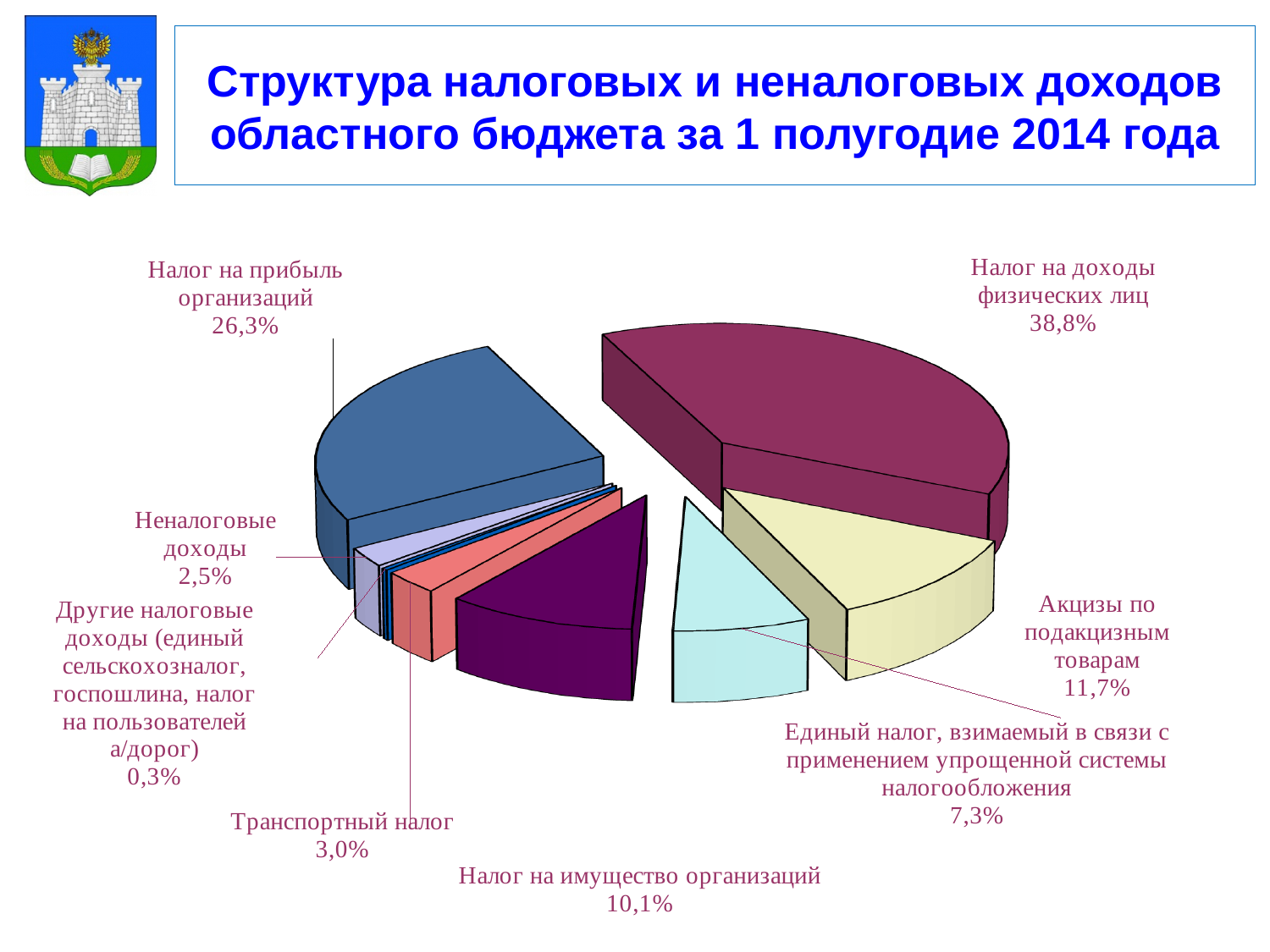
What share of the pie does "Налог на доходы физических лиц" have? 38,8% What is the value shown for "Акцизы по подакцизным товарам"? 11,7% Which category has the smallest share of the pie? Другие налоговые доходы (единый сельскохозналог, госпошлина, налог на пользователей а/дорог) Which is larger: "Акцизы по подакцизным товарам" or "Налог на имущество организаций"? Акцизы по подакцизным товарам What is the value shown for "Налог на имущество организаций"? 10,1% What is the title of the slide containing the chart? Структура налоговых и неналоговых доходов областного бюджета за 1 полугодие 2014 года What is the value shown for "Транспортный налог"? 3,0% Which category has the largest share of the pie? Налог на доходы физических лиц What is the value shown for "Налог на прибыль организаций"? 26,3% What kind of chart is shown on the slide? Pie chart How many slices does the pie chart have? 8 What is the difference between the shares of "Налог на доходы физических лиц" and "Налог на прибыль организаций"? 12,5%